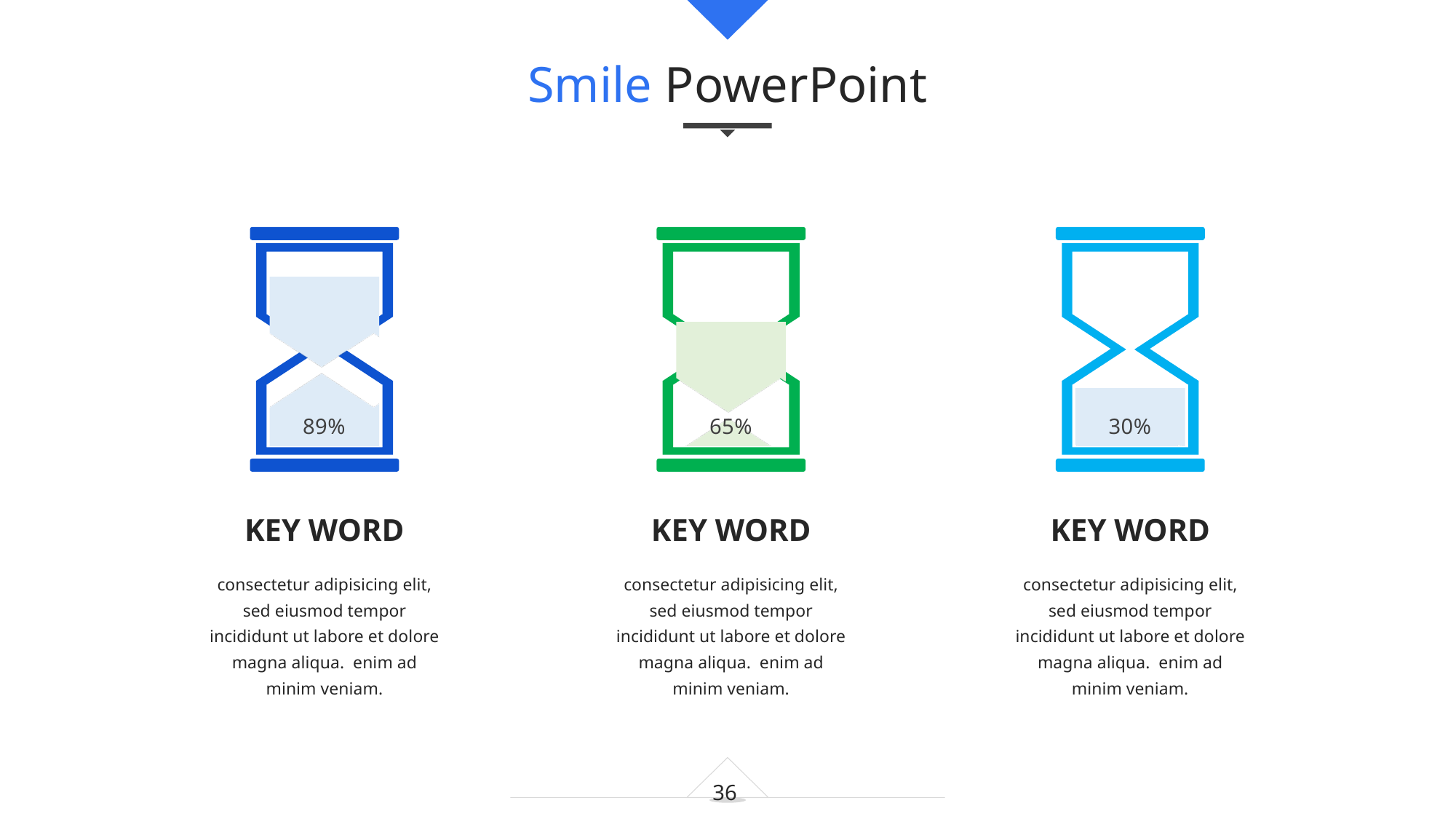
Which is larger, the percentage in the middle hourglass or the percentage in the right hourglass? middle hourglass What percentage is shown in the middle (green) hourglass? 65% What is the difference between the percentages in the left and middle hourglasses? 24% What colour is the hourglass that shows 65%? green Do the percentages rise or fall going from the left hourglass to the right hourglass? fall What is the difference between the percentages in the middle and right hourglasses? 35% How many hourglass graphics with percentages are shown on the slide? 3 Which hourglass shows the lowest percentage: left, middle or right? right What is the difference between the percentages in the left and right hourglasses? 59% What percentage is shown in the left (dark blue) hourglass? 89% What percentage is shown in the right (light blue) hourglass? 30% Which hourglass shows the highest percentage: left, middle or right? left